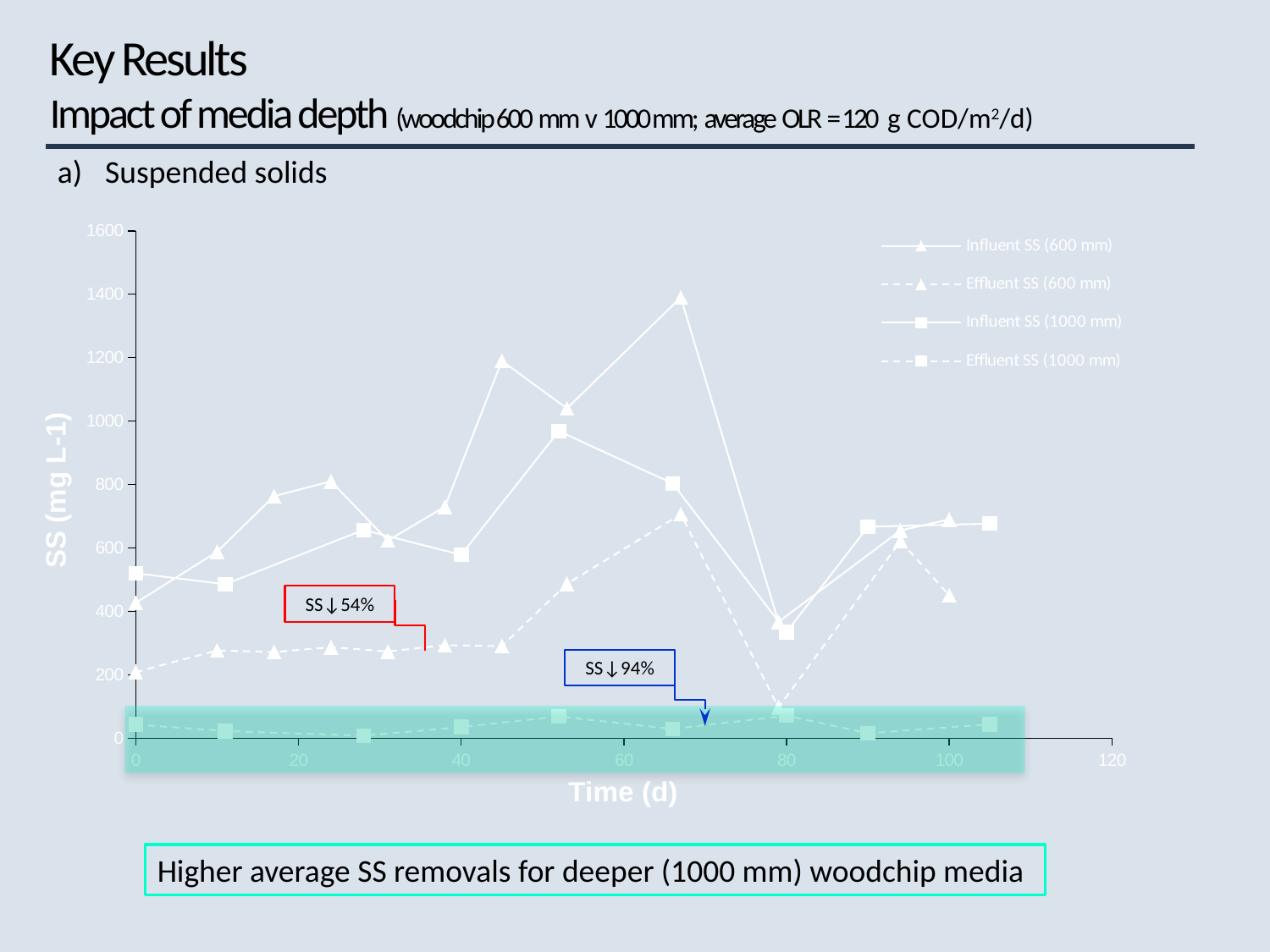
What is the label of the y axis? SS (mg L-1) Which is larger around day 67: Effluent SS (600 mm) or Effluent SS (1000 mm)? Effluent SS (600 mm) What SS reduction percentage is annotated for the 600 mm media? SS ↓ 54% Are the values of Effluent SS (1000 mm) greater or less than 200 throughout the chart? less How many series does the legend list? 4 What is the label of the x axis? Time (d) What kind of chart is shown on the slide? Line chart Is the peak value of Influent SS (600 mm) greater or less than 1200? greater Is the peak value of Influent SS (1000 mm) greater or less than 800? greater Which series reaches the highest value on the chart? Influent SS (600 mm) Which series has the lowest values throughout the chart? Effluent SS (1000 mm) Does Influent SS (600 mm) rise or fall between about day 67 and day 80? fall